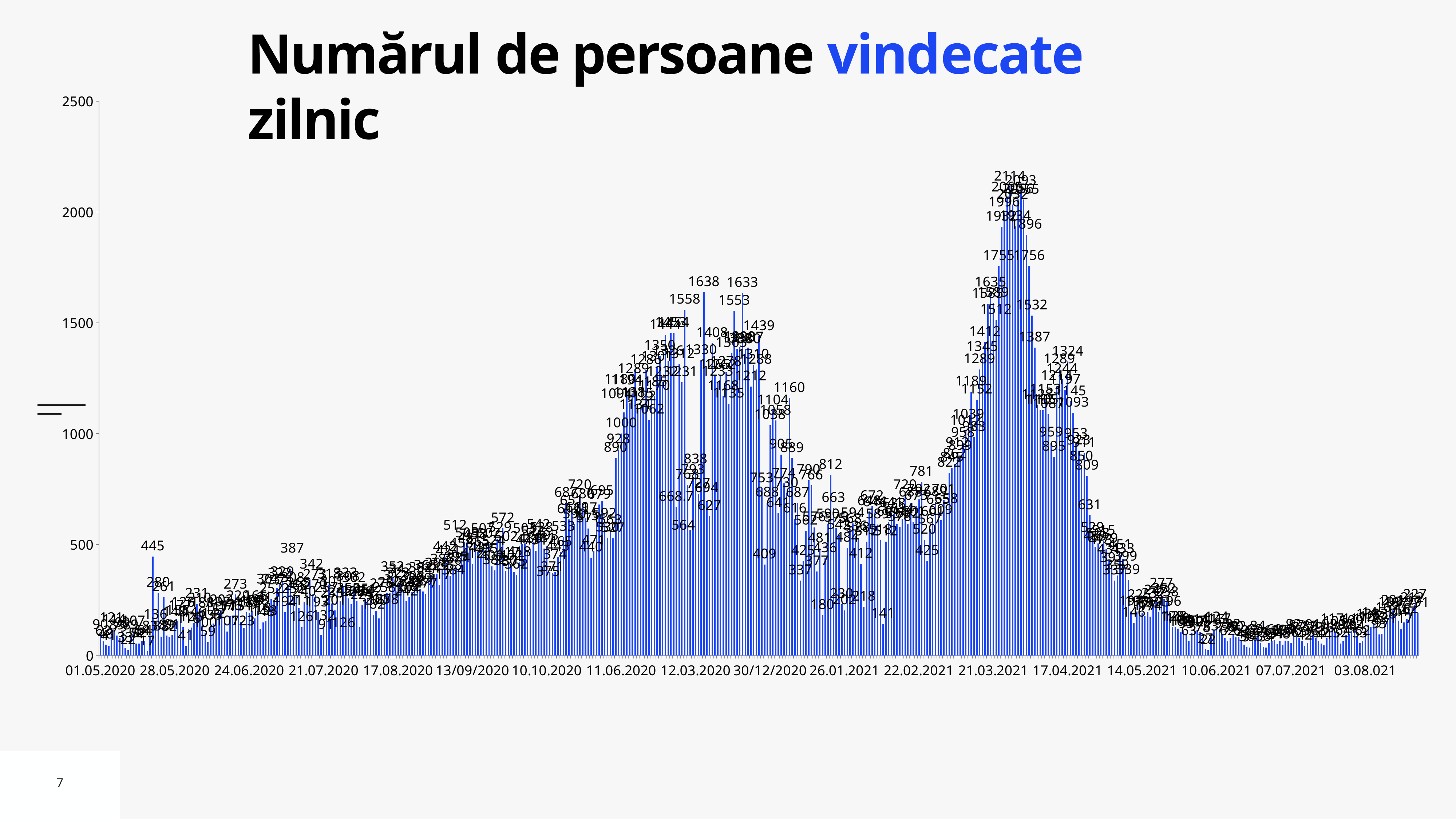
Which is larger, the peak labeled 2114 or the peak labeled 1638? 2114 Between 22.02.2021 and 21.03.2021, do the values rise or fall? rise Is the tallest bar on the chart greater or less than 2000? greater What is the difference between the peak labeled 2114 and the peak labeled 1638? 476 What kind of chart is shown on the slide? bar chart Are the bars around 07.07.2021 greater or less than 500? less What is the title of the chart? Numărul de persoane vindecate zilnic Between 17.04.2021 and 14.05.2021, do the values rise or fall? fall What is the value of the tallest bar between 24.06.2020 and 21.07.2020? 387 What is the value of the tallest bar between 13/09/2020 and 10.10.2020? 572 What is the value of the tallest bar between 01.05.2020 and 28.05.2020? 445 What is the highest value labeled on the chart? 2114